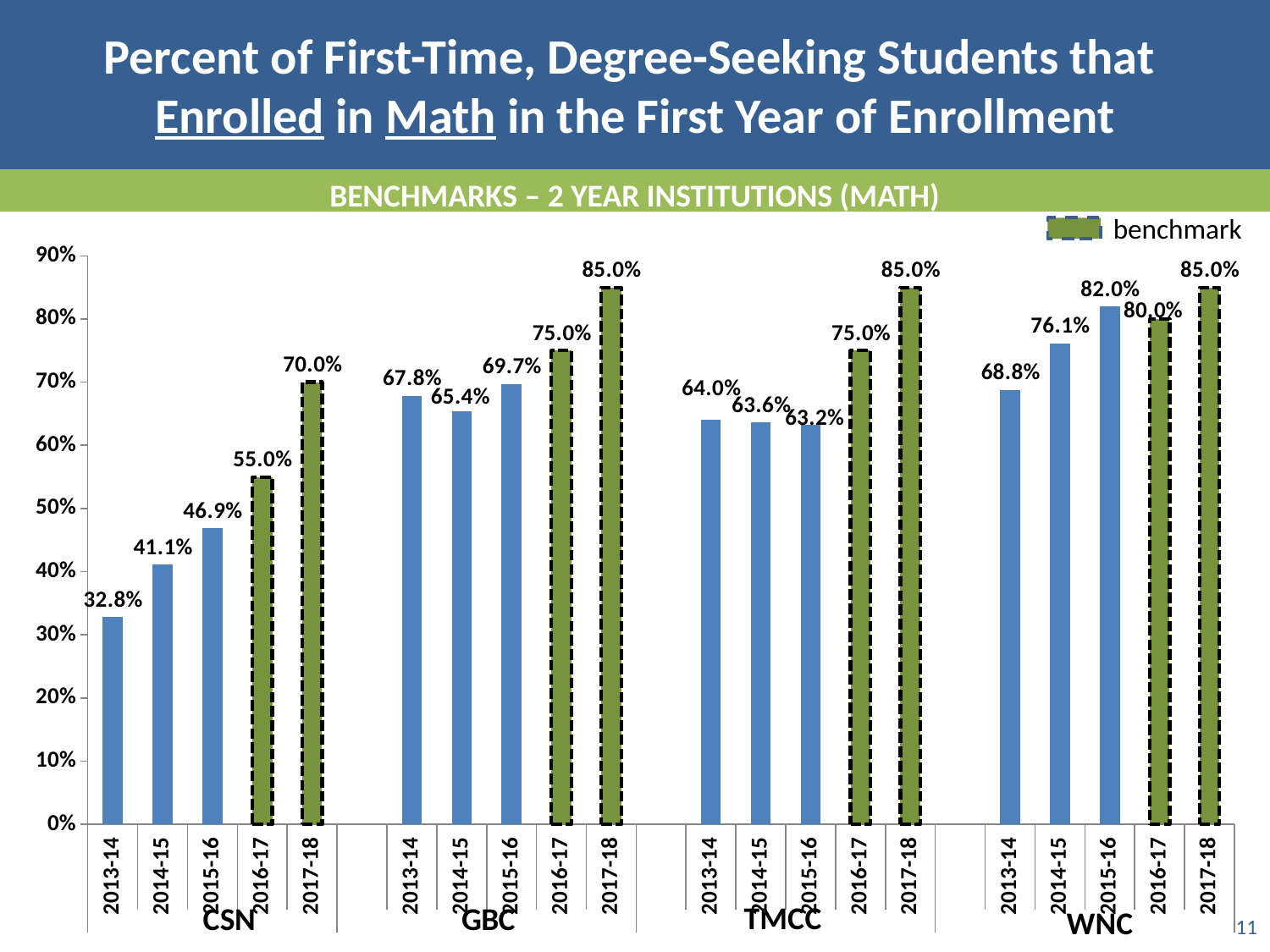
What is the 2017-18 benchmark value for CSN? 70.0% What kind of chart is shown on the slide? Bar chart Which is larger, the TMCC value for 2013-14 or the GBC value for 2014-15? GBC 2014-15 What is the value for GBC in 2015-16? 69.7% What is the value for CSN in 2013-14? 32.8% What is the value for WNC in 2015-16? 82.0% What is the difference between the CSN values for 2015-16 and 2014-15? 5.8% Which institution has the lowest value in 2013-14? CSN How many institutions are shown on the chart? 4 What does the legend entry with the green dashed bar represent? benchmark Which institution has the highest value in 2015-16? WNC Is the value for TMCC in 2015-16 greater or less than 60%? greater